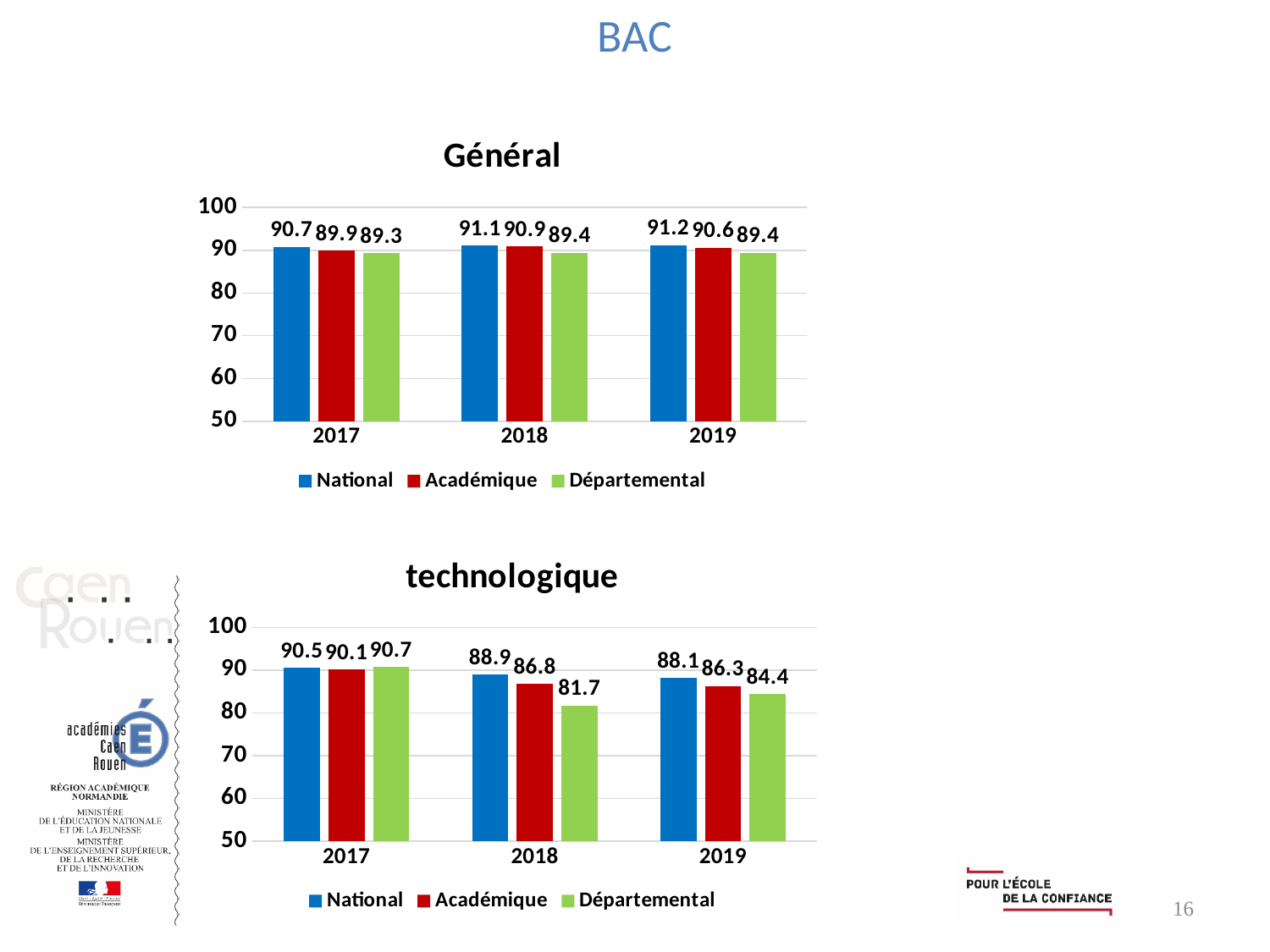
In the 'technologique' chart, what is the Départemental value for 2018? 81.7 In the 'technologique' chart, which year has the lowest Départemental value? 2018 In the 'technologique' chart, is the Départemental value for 2017 larger or smaller than the Départemental value for 2019? larger In the 'technologique' chart, which year has the highest National value? 2017 How many series does the legend of the 'Général' chart list? 3 In the 'Général' chart, what is the difference between the National and Académique values for 2019? 0.6 In the 'Général' chart, what is the National value for 2018? 91.1 What kind of chart is the 'technologique' chart? bar chart In the 'technologique' chart, what is the Académique value for 2019? 86.3 In the 'technologique' chart, does the National value rise or fall from 2017 to 2019? fall In the 'technologique' chart, what is the difference between the National and Départemental values for 2018? 7.2 In the 'Général' chart, what is the Départemental value for 2017? 89.3